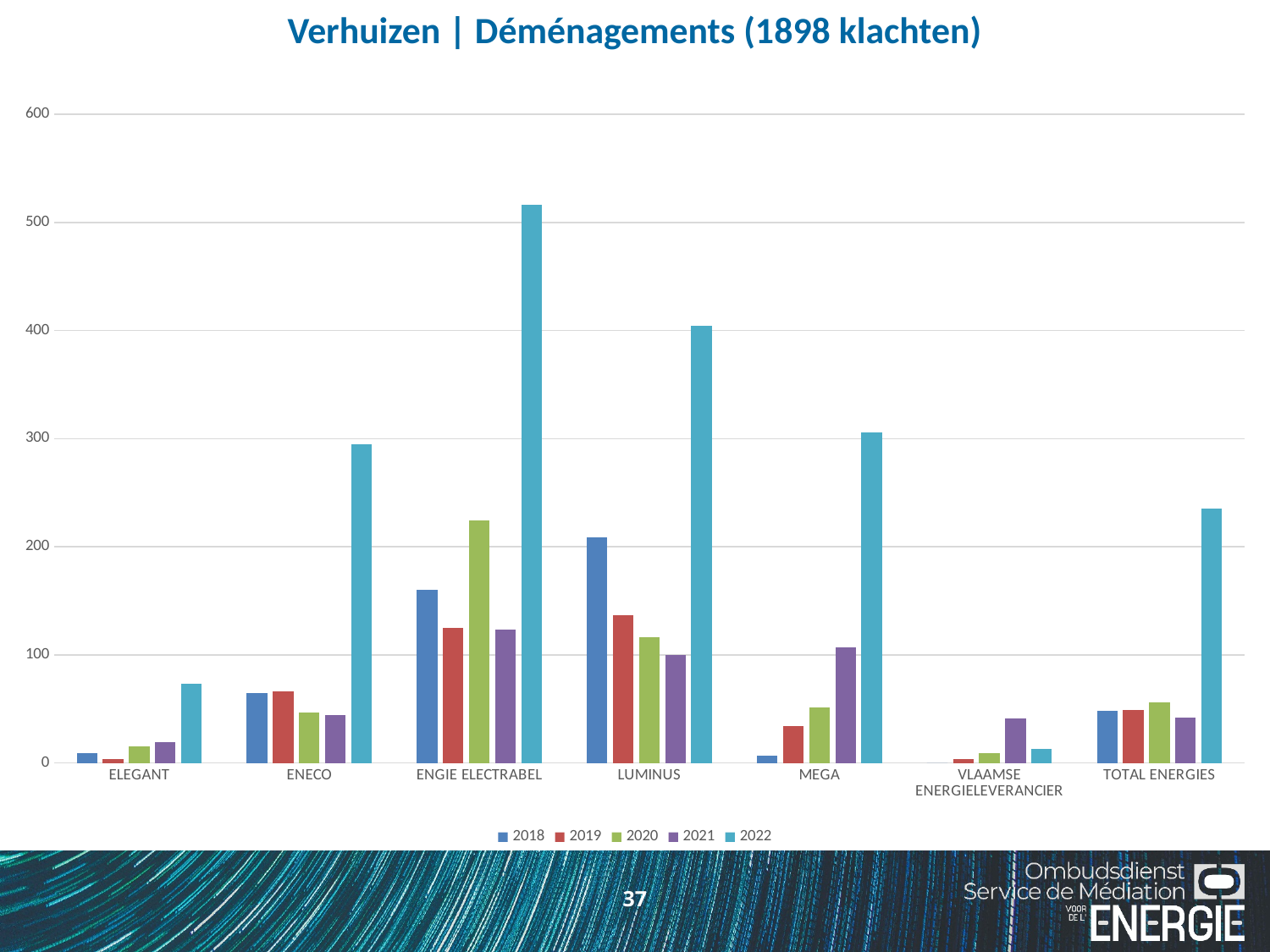
Is the 2022 value for ENGIE ELECTRABEL greater or less than 500? greater How many supplier categories are shown on the x axis? 7 Which supplier has the lowest bar for 2022? VLAAMSE ENERGIELEVERANCIER Is the 2022 value for TOTAL ENERGIES greater or less than 200? greater How many complaints does the chart title mention? 1898 Which supplier has the highest bar for 2022? ENGIE ELECTRABEL Which is larger, the 2022 value for LUMINUS or the 2022 value for MEGA? LUMINUS What kind of chart is shown on the slide? bar chart Which is larger, the 2018 value for ENGIE ELECTRABEL or the 2018 value for LUMINUS? LUMINUS Is the 2022 value for ELEGANT greater or less than 100? less How many series does the legend list? 5 For MEGA, do the values rise or fall from 2018 to 2022? rise